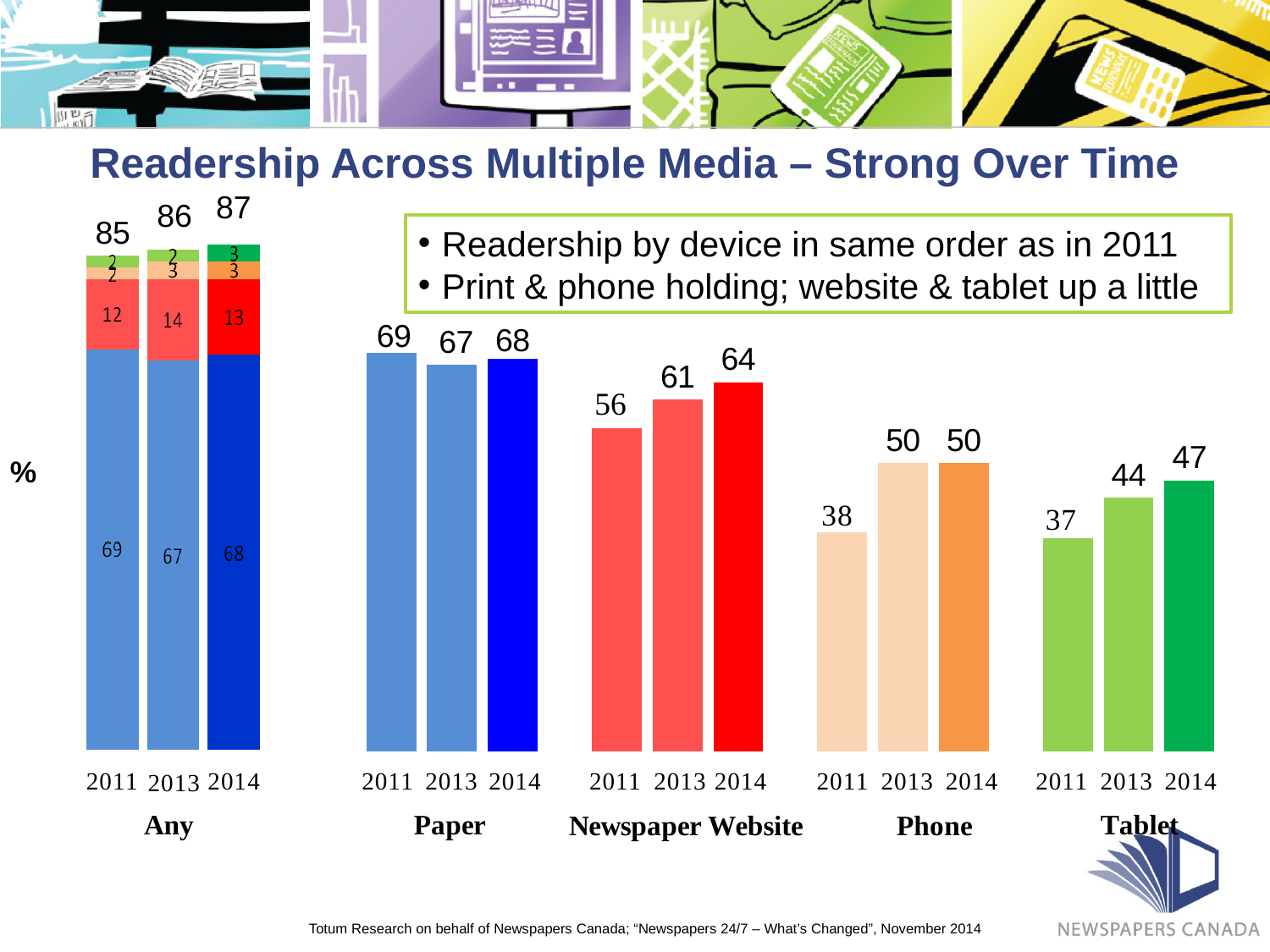
In the right-hand chart, what is the Tablet value for 2013? 44 In the right-hand chart, which year has the highest Newspaper Website value? 2014 In the right-hand chart, what is the Newspaper Website value for 2014? 64 In the left-hand 'Any' stacked chart, what is the total for 2011? 85 In the right-hand chart, which is larger: Paper in 2014 or Newspaper Website in 2014? Paper in 2014 What type of chart is used on this slide? bar chart In the right-hand chart, do the Tablet values rise or fall from 2011 to 2014? rise In the right-hand chart, what is the difference between the Phone values for 2013 and 2011? 12 In the left-hand 'Any' stacked chart, what is the total for 2014? 87 In the right-hand chart, what is the Paper readership value for 2011? 69 In the right-hand chart, what is the Phone value for 2011? 38 In the right-hand chart, which year has the lowest Tablet value? 2011